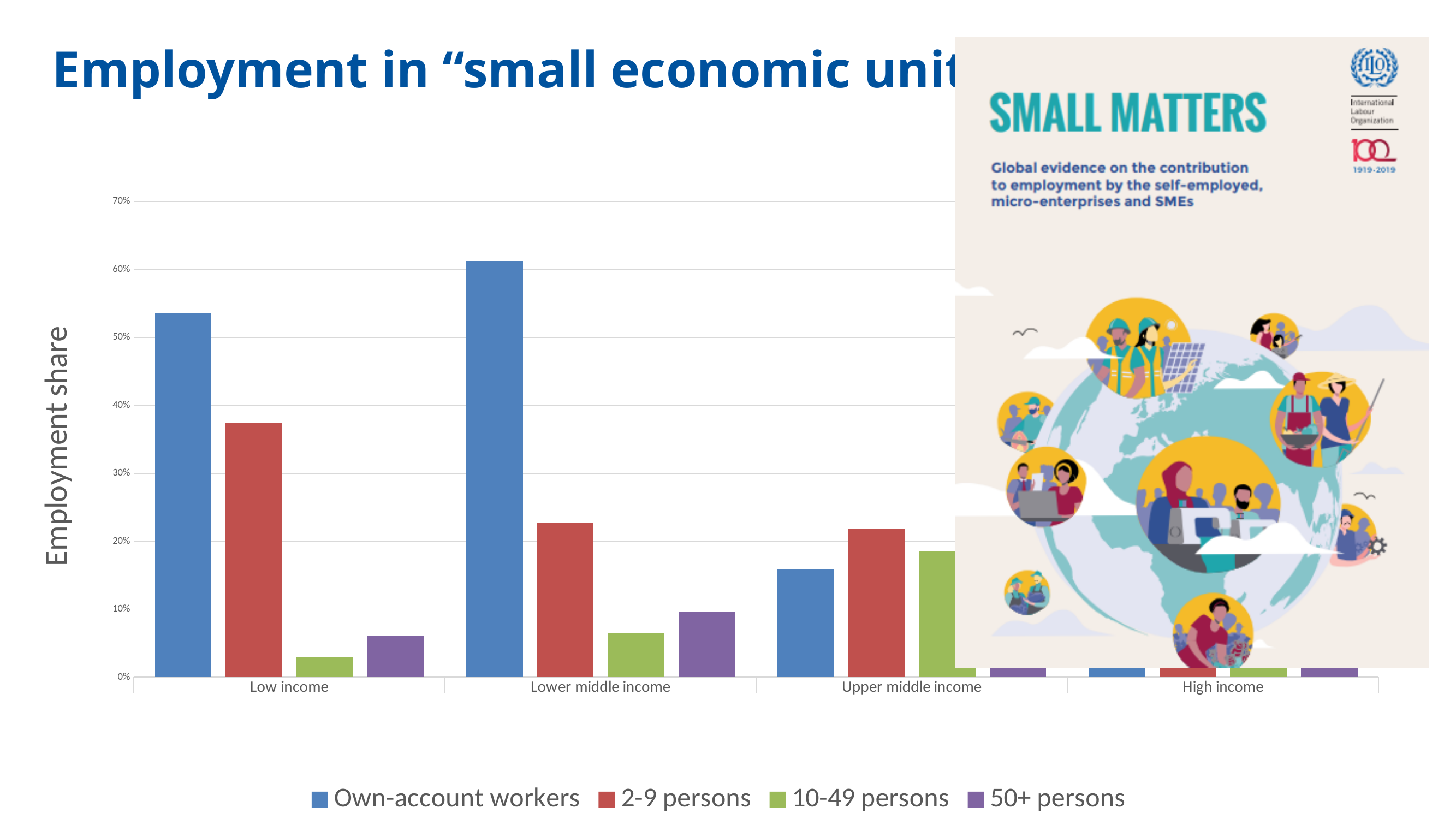
Which series has the lowest value in the Low income category? 10-49 persons What kind of chart is shown on the slide? Bar chart How many series does the legend list? 4 Is the value for 2-9 persons in Lower middle income greater or less than 20%? greater Which series has the highest value in the Lower middle income category? Own-account workers Which is larger: Own-account workers in Low income or Own-account workers in Lower middle income? Lower middle income What is the label on the vertical axis of the chart? Employment share Which is larger in Upper middle income: Own-account workers or 2-9 persons? 2-9 persons How many income categories are shown on the x axis? 4 Is the value for 2-9 persons in Low income greater or less than 40%? less Is the value for Own-account workers in Low income greater or less than 50%? greater